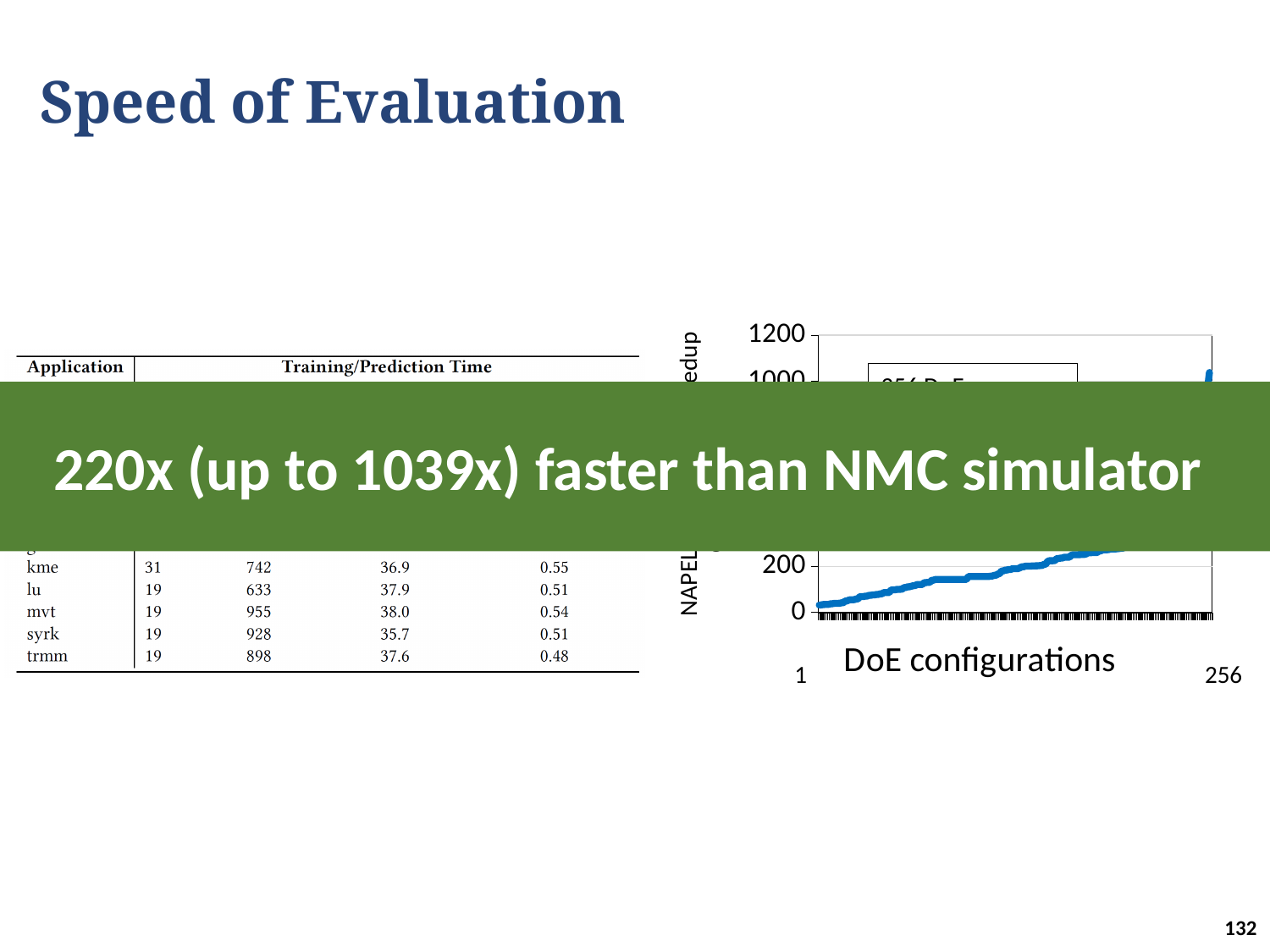
What is the highest tick value shown on the y axis of the chart on the right? 1200 In the chart on the right, is the value for the first DoE configuration greater or less than 200? less What is the largest x-axis value shown on the chart on the right? 256 In the chart on the right, do the values rise or fall as you move along the x axis from configuration 1 to 256? rise In the chart on the right, which has the larger value: DoE configuration 1 or DoE configuration 256? DoE configuration 256 What kind of chart is shown on the right of the slide? line chart What is the x-axis label of the chart on the right? DoE configurations In the chart on the right, is the value for the last DoE configuration (256) greater or less than 1000? greater